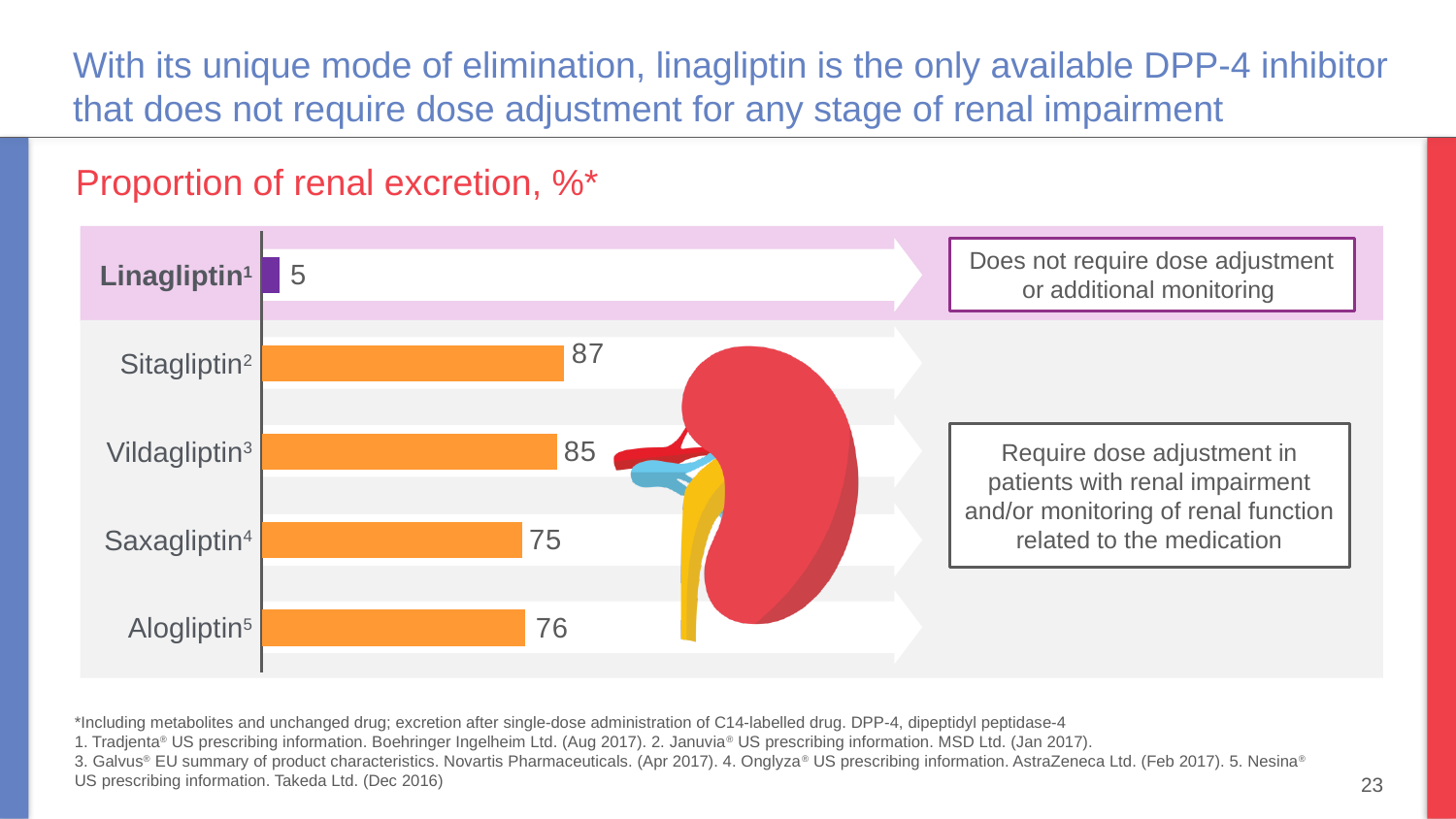
Which drug has the lowest proportion of renal excretion? Linagliptin What is the proportion of renal excretion for alogliptin? 76 Which has a higher proportion of renal excretion, sitagliptin or vildagliptin? Sitagliptin What is the proportion of renal excretion for linagliptin? 5 What is the proportion of renal excretion for saxagliptin? 75 What is the proportion of renal excretion for sitagliptin? 87 What is the difference in proportion of renal excretion between sitagliptin and linagliptin? 82 What is the title of the chart? Proportion of renal excretion, %* What kind of chart is shown on the slide? Bar chart Which drug has the highest proportion of renal excretion? Sitagliptin How many drugs are shown in the chart? 5 What is the difference in proportion of renal excretion between vildagliptin and saxagliptin? 10